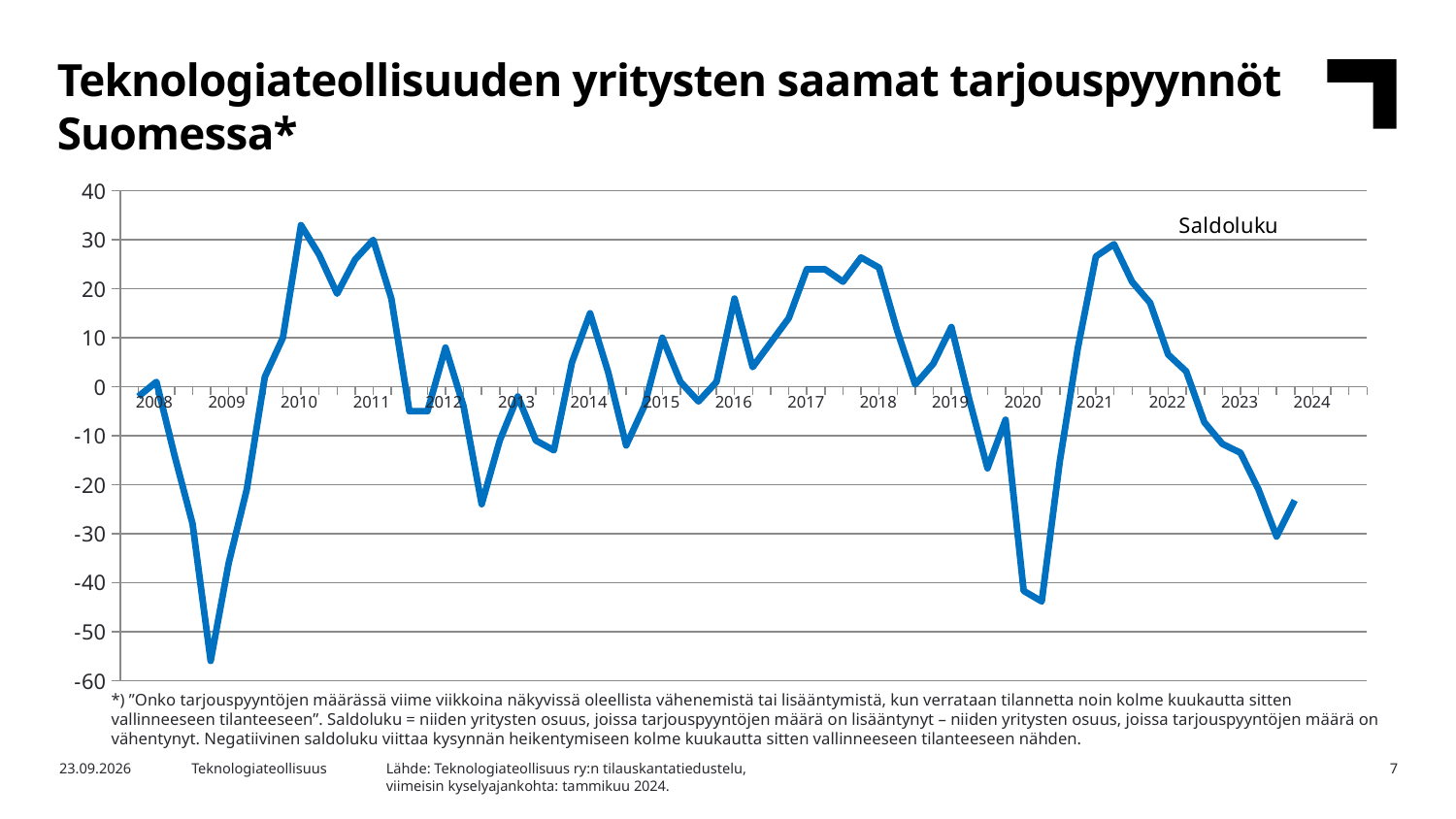
What kind of chart is shown on the slide? line chart Is the lowest value of the line in 2020 greater or less than -40? less Which is larger, the peak value of the line in 2010 or the peak value in 2019? 2010 Is the lowest value of the line in 2009 greater or less than -50? less What is the name of the series plotted in the chart? Saldoluku In which year does the line reach its lowest point? 2009 Does the line rise or fall between 2021 and 2023? fall How many year labels are shown on the x axis? 17 Does the line rise or fall between 2008 and 2009? fall How many series does the chart plot? 1 Is the peak value of the line in 2010 greater or less than 30? greater What is the title of the chart on the slide? Saldoluku